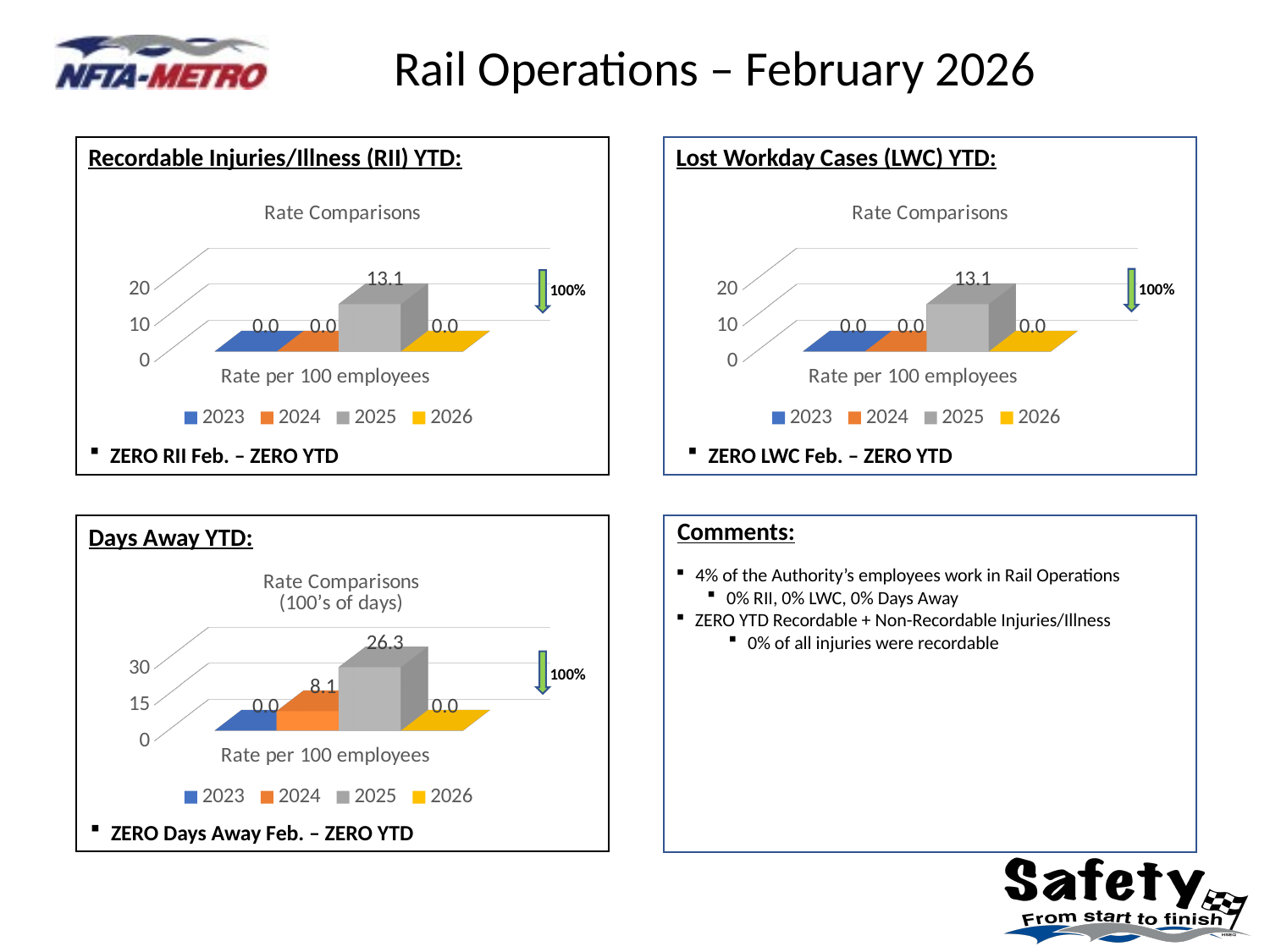
What kind of chart is the Days Away YTD chart? Bar chart In the Days Away YTD chart, is the value for 2025 greater or less than 15? greater In the Lost Workday Cases (LWC) YTD chart, which year has the highest value? 2025 In the Recordable Injuries/Illness (RII) YTD chart, what is the value for 2025? 13.1 In the Lost Workday Cases (LWC) YTD chart, what is the value for 2024? 0.0 In the Recordable Injuries/Illness (RII) YTD chart, what is the value for 2026? 0.0 How many series does the legend list in the Recordable Injuries/Illness (RII) YTD chart? 4 What is the x-axis label in the Lost Workday Cases (LWC) YTD chart? Rate per 100 employees In the Days Away YTD chart, what is the value for 2024? 8.1 In the Days Away YTD chart, what is the difference between the 2025 and 2024 values? 18.2 In the Days Away YTD chart, what is the value for 2025? 26.3 In the Days Away YTD chart, which is larger, the value for 2024 or the value for 2025? 2025